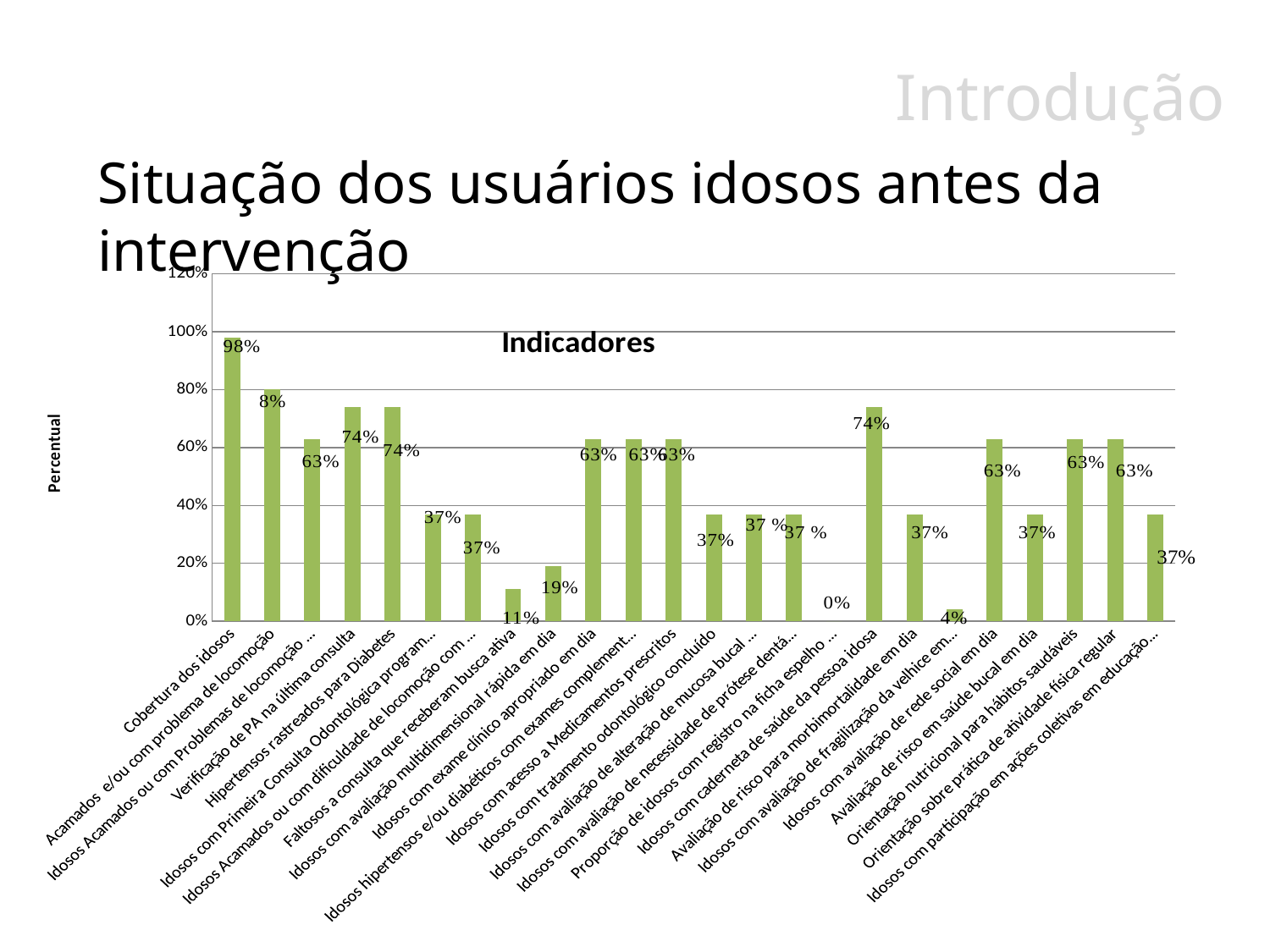
What is the difference between 'Cobertura dos idosos' and 'Verificação de PA na última consulta'? 24 percentage points What is the value for 'Idosos com avaliação multidimensional rápida em dia'? 19% What is the value for 'Orientação nutricional para hábitos saudáveis'? 63% What is the value for 'Idosos com caderneta de saúde da pessoa idosa'? 74% Which category has the highest value? Cobertura dos idosos What is the value for 'Cobertura dos idosos'? 98% Is the value for 'Hipertensos rastreados para Diabetes' greater or less than 60%? greater What is the value for 'Faltosos a consulta que receberam busca ativa'? 11% What kind of chart is shown on the slide? Bar chart What is the title of the chart? Indicadores Which is larger: 'Idosos com acesso a Medicamentos prescritos' or 'Idosos com tratamento odontológico concluído'? Idosos com acesso a Medicamentos prescritos Which category has the lowest value? Proporção de idosos com registro na ficha espelho